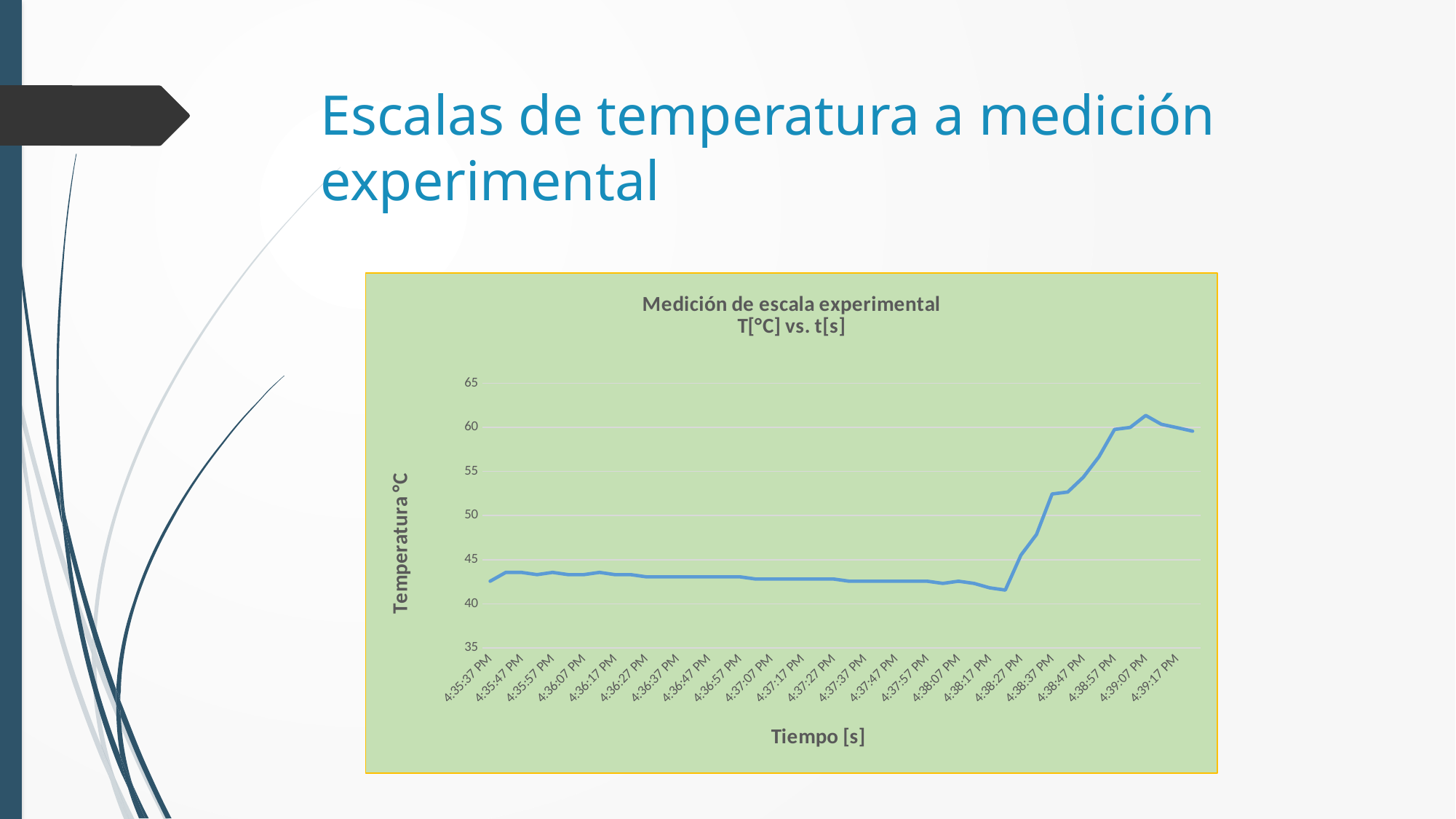
What is the label of the vertical axis of the chart? Temperatura °C What is the title of the chart? Medición de escala experimental T[°C] vs. t[s] Is the temperature at 4:35:37 PM greater or less than 45? less Is the temperature at 4:38:37 PM greater or less than 50? greater What kind of chart is shown on the slide? Line chart Does the temperature rise or fall between 4:38:17 PM and 4:39:07 PM? rise Is the temperature at 4:39:07 PM greater or less than 60? greater Does the temperature rise or fall between 4:39:07 PM and 4:39:17 PM? fall Which is higher, the temperature at 4:38:47 PM or at 4:35:37 PM? 4:38:47 PM At which time does the temperature reach its highest value? 4:39:07 PM